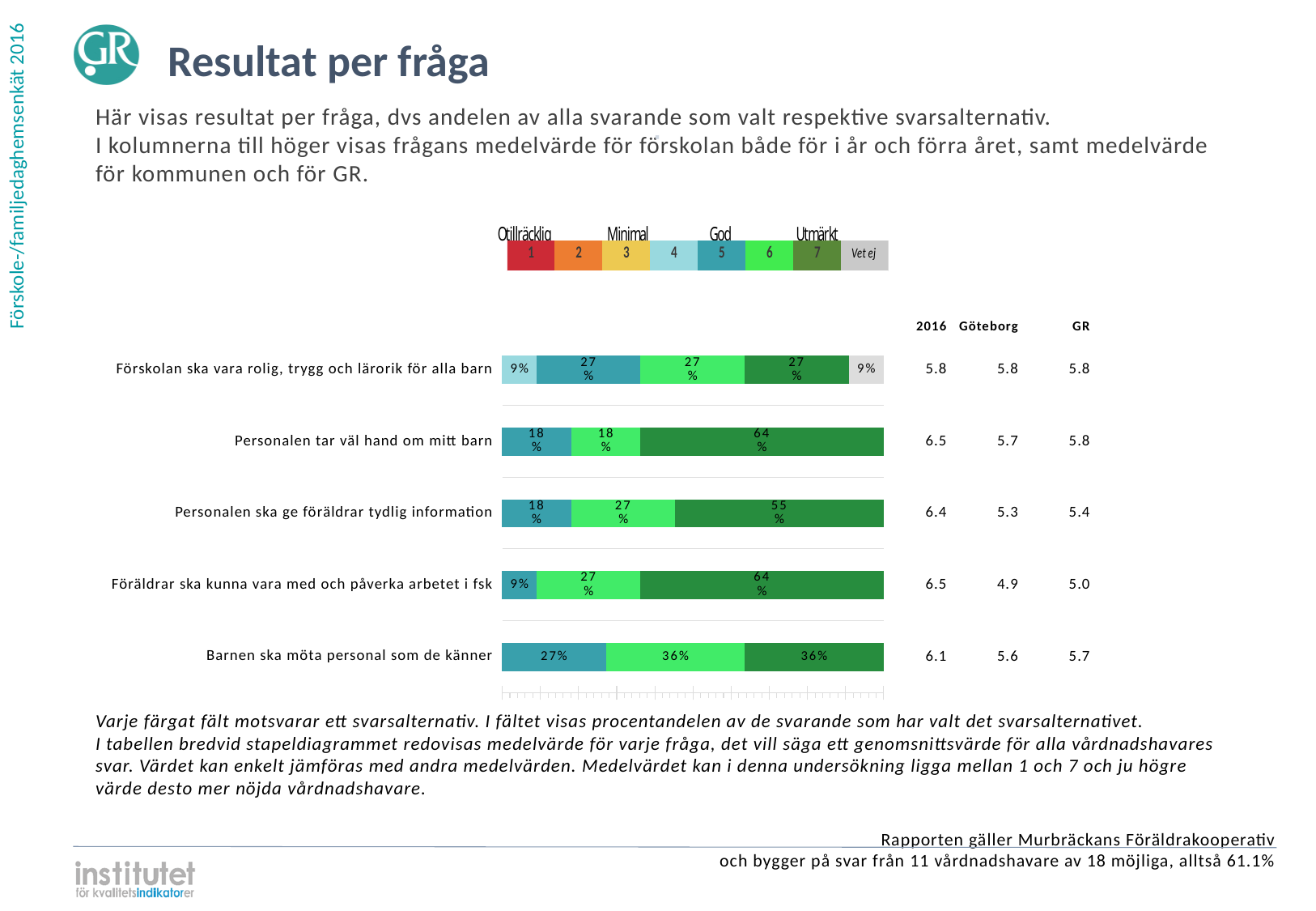
What is the difference between the share choosing answer 7 and the share choosing answer 6 for "Personalen ska ge föräldrar tydlig information"? 28% What percentage of respondents chose answer 7 (Utmärkt) for "Personalen tar väl hand om mitt barn"? 64% What is the combined share of respondents choosing answers 5, 6 and 7 for "Barnen ska möta personal som de känner"? 99% What kind of chart is used to show the results per question? Stacked bar chart What is the 2016 mean value for "Personalen ska ge föräldrar tydlig information"? 6.4 What percentage of respondents chose answer 6 for "Barnen ska möta personal som de känner"? 36% How many questions (categories) are shown in the bar chart? 5 For "Föräldrar ska kunna vara med och påverka arbetet i fsk", which is larger: the share choosing answer 5 or the share choosing answer 6? Answer 6 (27%) Which question has the lowest share of respondents choosing answer 7 (dark green)? Förskolan ska vara rolig, trygg och lärorik för alla barn What is the Göteborg mean value for "Föräldrar ska kunna vara med och påverka arbetet i fsk"? 4.9 How many answer alternatives, including "Vet ej", does the legend above the chart show? 8 What percentage of respondents answered "Vet ej" for "Förskolan ska vara rolig, trygg och lärorik för alla barn"? 9%